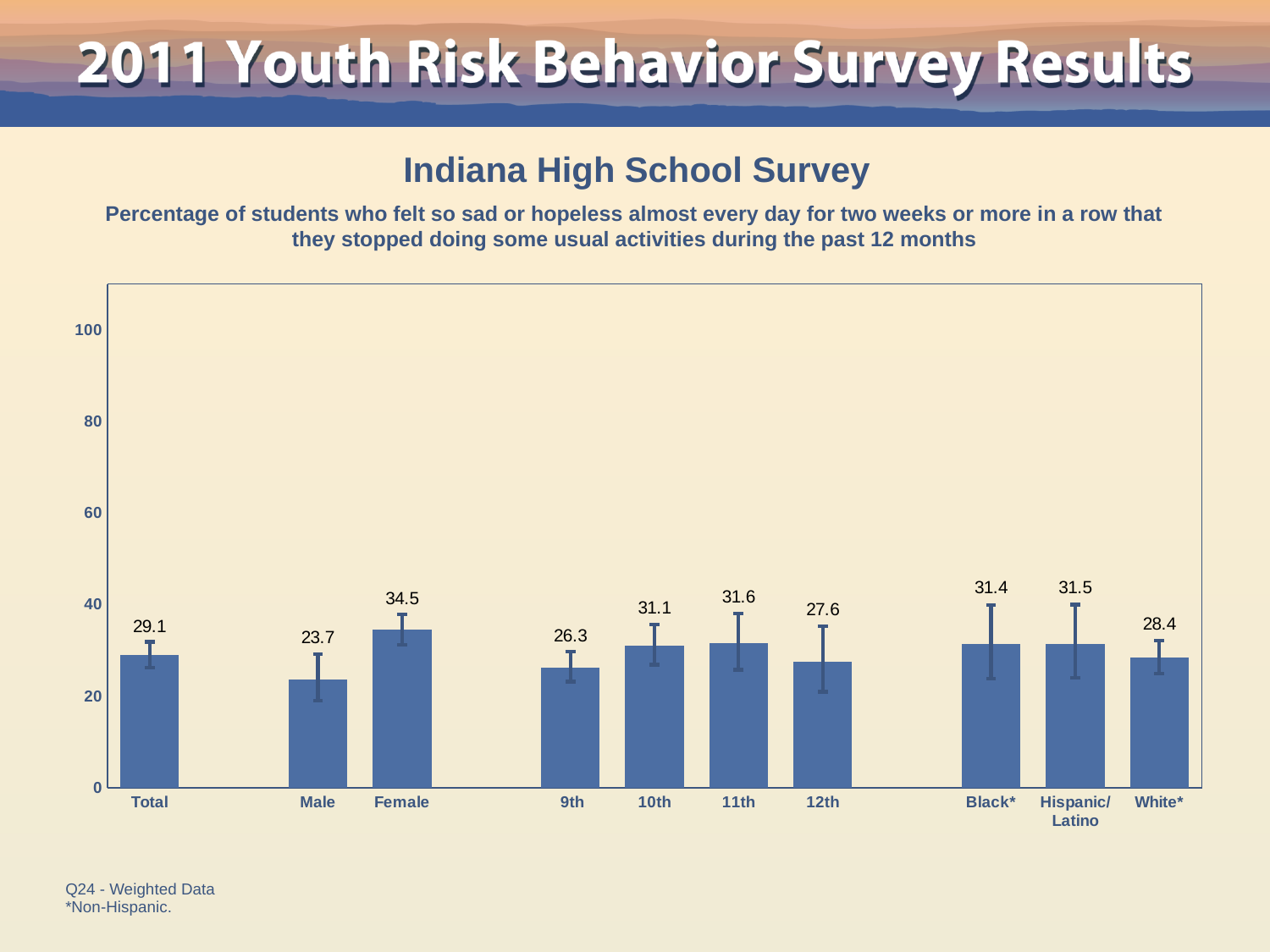
What is the difference between the White* and Black* values? 3.0 Is the value for Female greater or less than 40? less What is the value for Female? 34.5 Which category has the highest value? Female Which is larger, the value for 9th or the value for 10th? 10th What is the value for Total? 29.1 Do the values rise or fall from 9th to 11th grade? rise What is the difference between the Female and Male values? 10.8 What is the value for 12th grade? 27.6 How many categories are shown on the x axis? 10 Which category has the lowest value? Male What kind of chart is this? bar chart